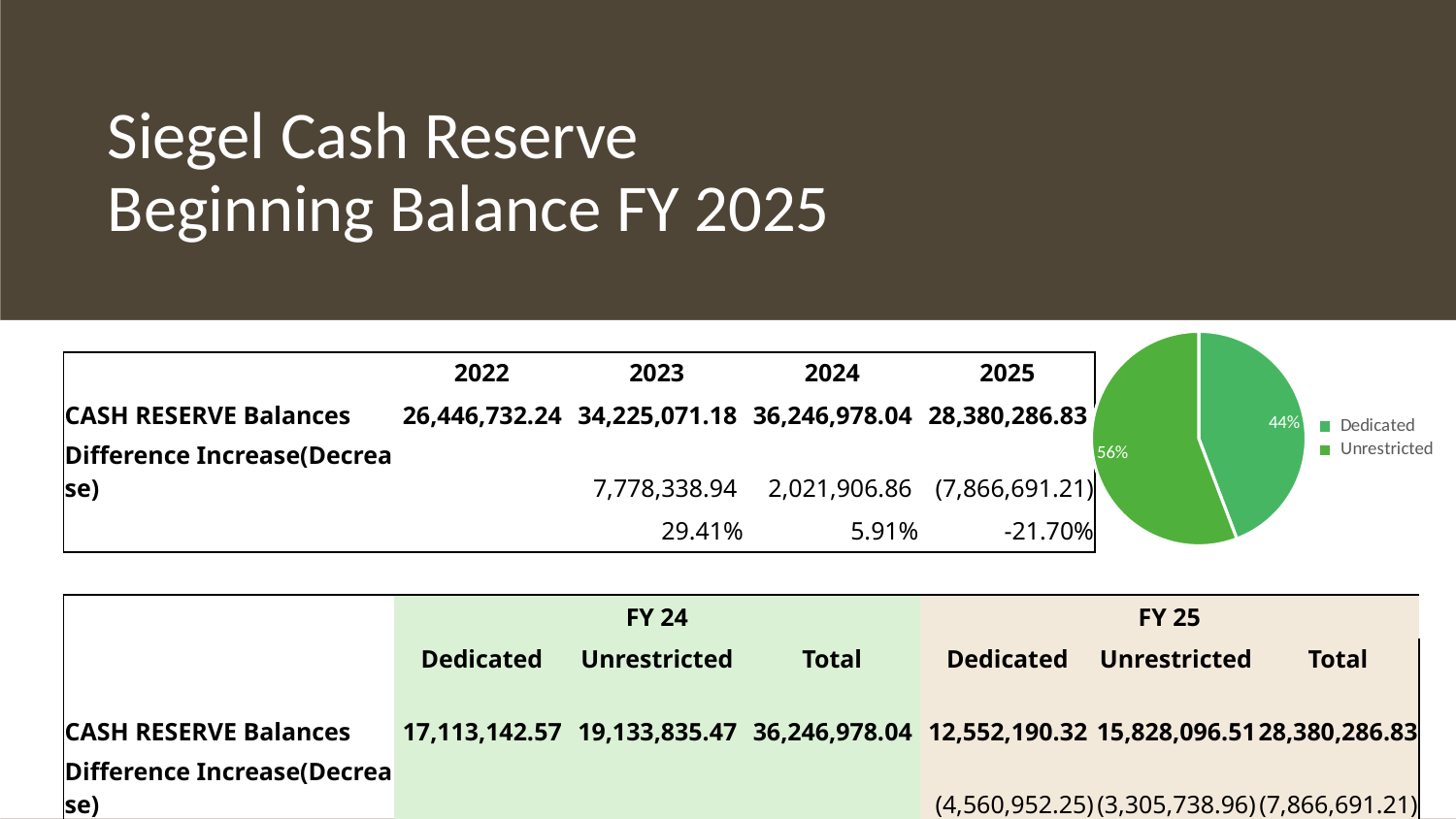
What kind of chart is shown on the slide? pie chart What share of the pie chart is labelled Dedicated? 44% What share of the pie chart is labelled Unrestricted? 56% Which slice of the pie chart is the largest? Unrestricted How many entries does the pie chart's legend list? 2 Is the Dedicated share of the pie chart greater or less than 50%? less What colour family are the slices of the pie chart? green Which slice of the pie chart is the smallest? Dedicated In the pie chart, which is larger, Dedicated or Unrestricted? Unrestricted How many slices does the pie chart have? 2 What are the two legend entries of the pie chart? Dedicated and Unrestricted What is the difference in percentage points between the Unrestricted and Dedicated slices of the pie chart? 12